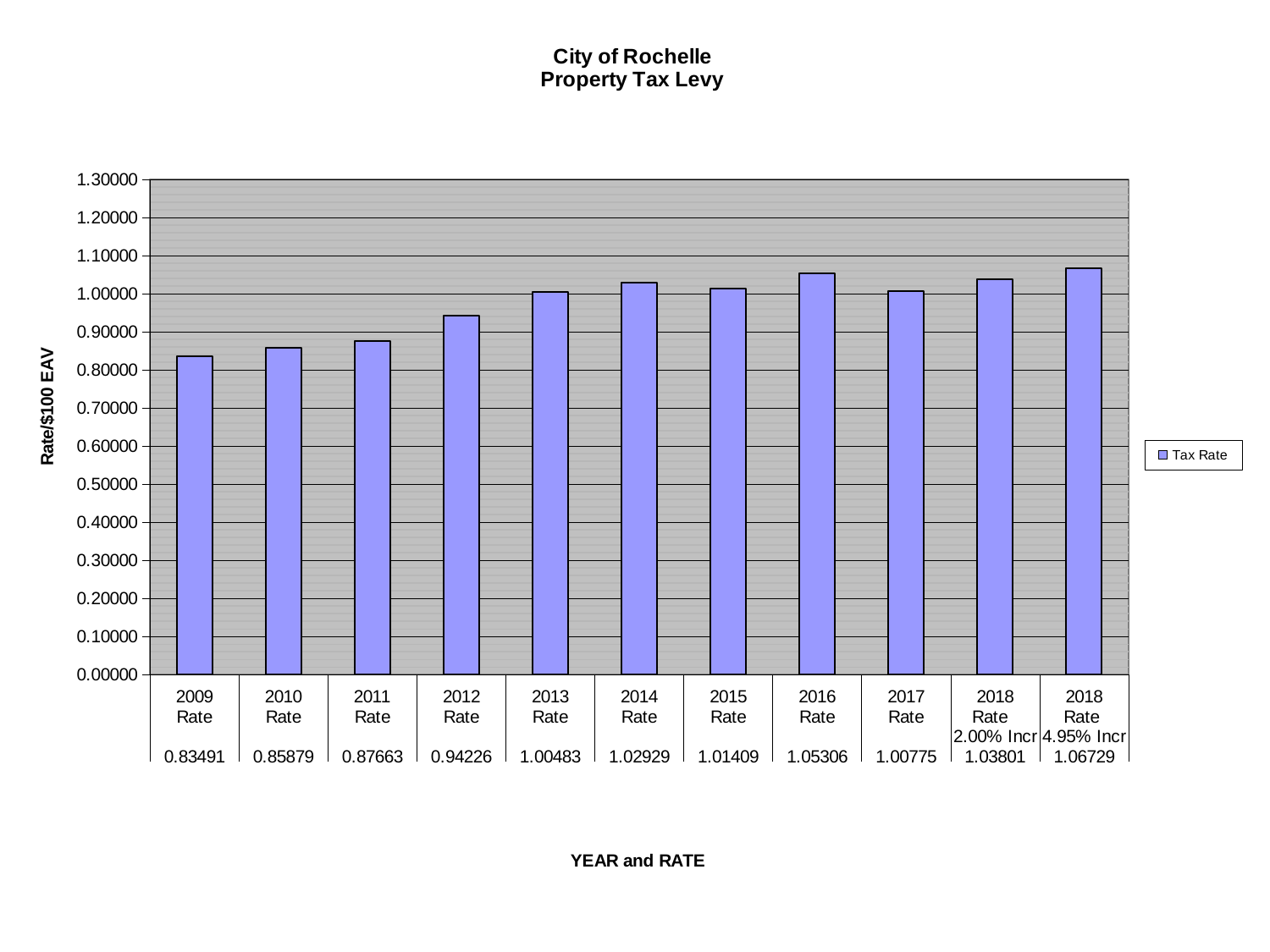
Is the value for 2012 greater or less than 1.00000? less How many bars are shown in the chart? 11 What is the tax rate for 2016? 1.05306 What is the tax rate for 2018 with the 4.95% increase? 1.06729 Which is larger, the 2014 rate or the 2015 rate? 2014 rate Which category has the highest tax rate? 2018 Rate 4.95% Incr Which year has the lowest tax rate? 2009 What kind of chart is shown? bar chart What is the difference between the 2016 rate and the 2015 rate? 0.03897 How many series does the legend list? 1 What is the tax rate for 2009? 0.83491 What is the difference between the 2010 rate and the 2009 rate? 0.02388